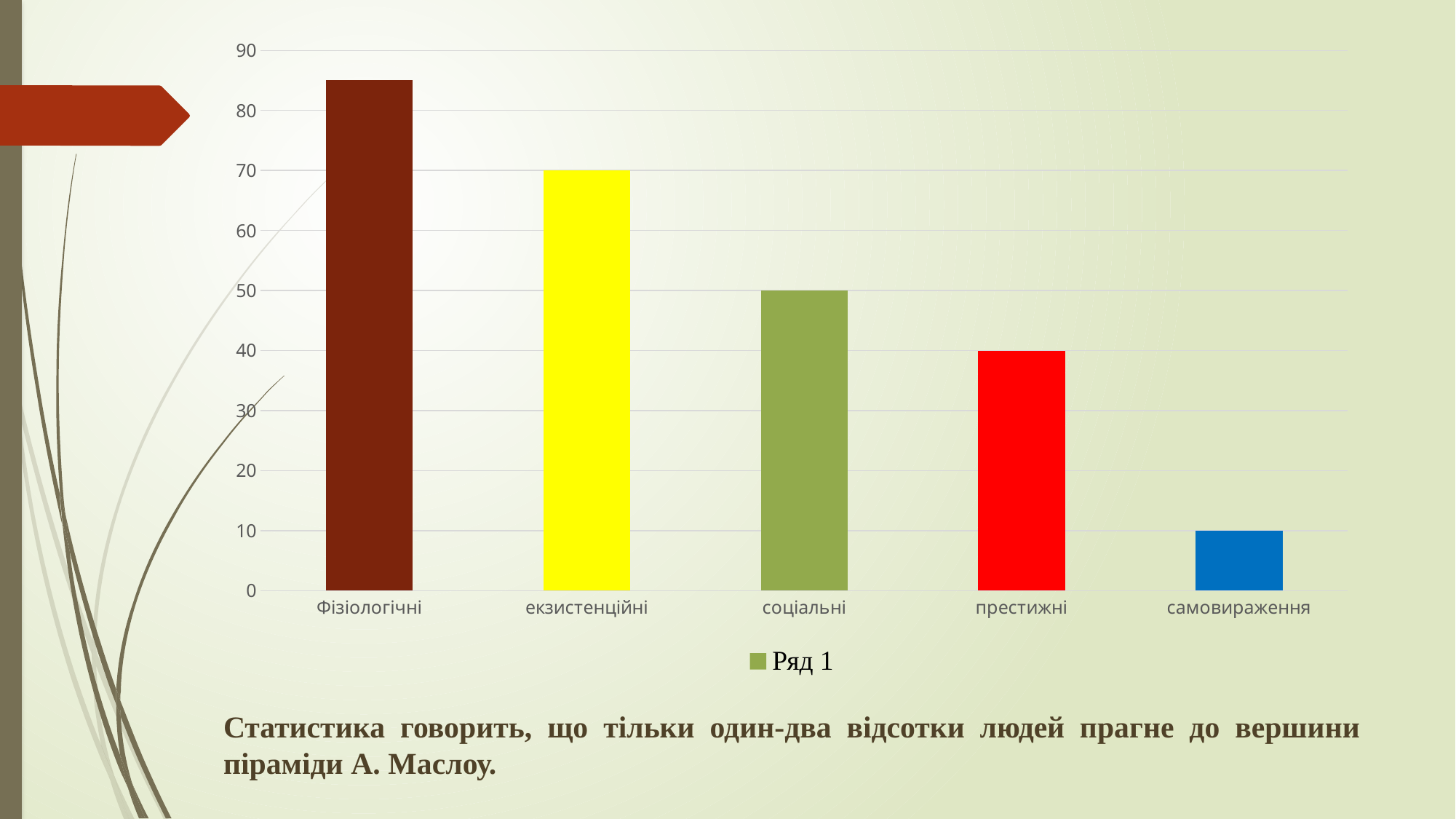
What is the name of the series shown in the chart legend? Ряд 1 Do the values rise or fall from left to right along the x axis? fall How many series does the chart legend list? 1 What is the value for екзистенційні? 70 Which category has the highest value in the chart? Фізіологічні What is the difference between the values for екзистенційні and престижні? 30 Which category has the lowest value in the chart? самовираження What kind of chart is shown on the slide? bar chart How many categories are shown on the x axis of the chart? 5 What is the value for самовираження? 10 What is the value for соціальні? 50 Is the value for Фізіологічні greater or less than 80? greater